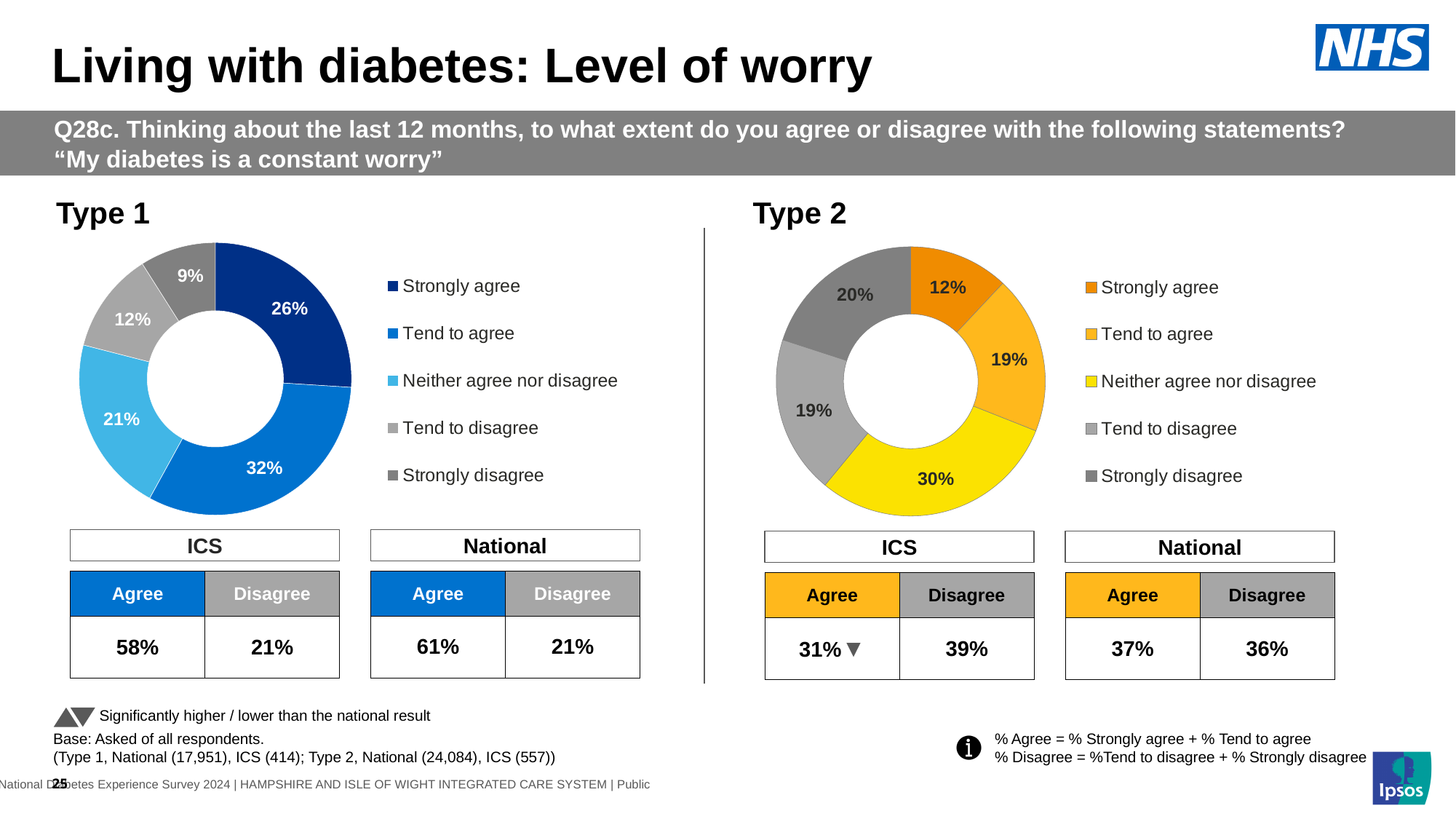
What kind of chart is used for Type 2? Donut (pie) chart In the Type 1 chart, which response category has the largest share? Tend to agree In the Type 1 chart, what percentage of respondents said they strongly agree? 26% In the Type 2 chart, which response category has the smallest share? Strongly agree In the Type 2 chart, is the Strongly disagree share larger or smaller than the Tend to agree share? larger In the Type 2 chart, which response category has the largest share? Neither agree nor disagree In the Type 2 chart, what percentage of respondents said they neither agree nor disagree? 30% In the Type 2 chart, what percentage of respondents said they strongly disagree? 20% In the Type 1 chart, what percentage of respondents said they tend to agree? 32% How many response categories does the legend of the Type 1 chart list? 5 In the Type 1 chart, which response category has the smallest share? Strongly disagree In the Type 1 chart, what is the difference between the Tend to agree share and the Neither agree nor disagree share? 11 percentage points